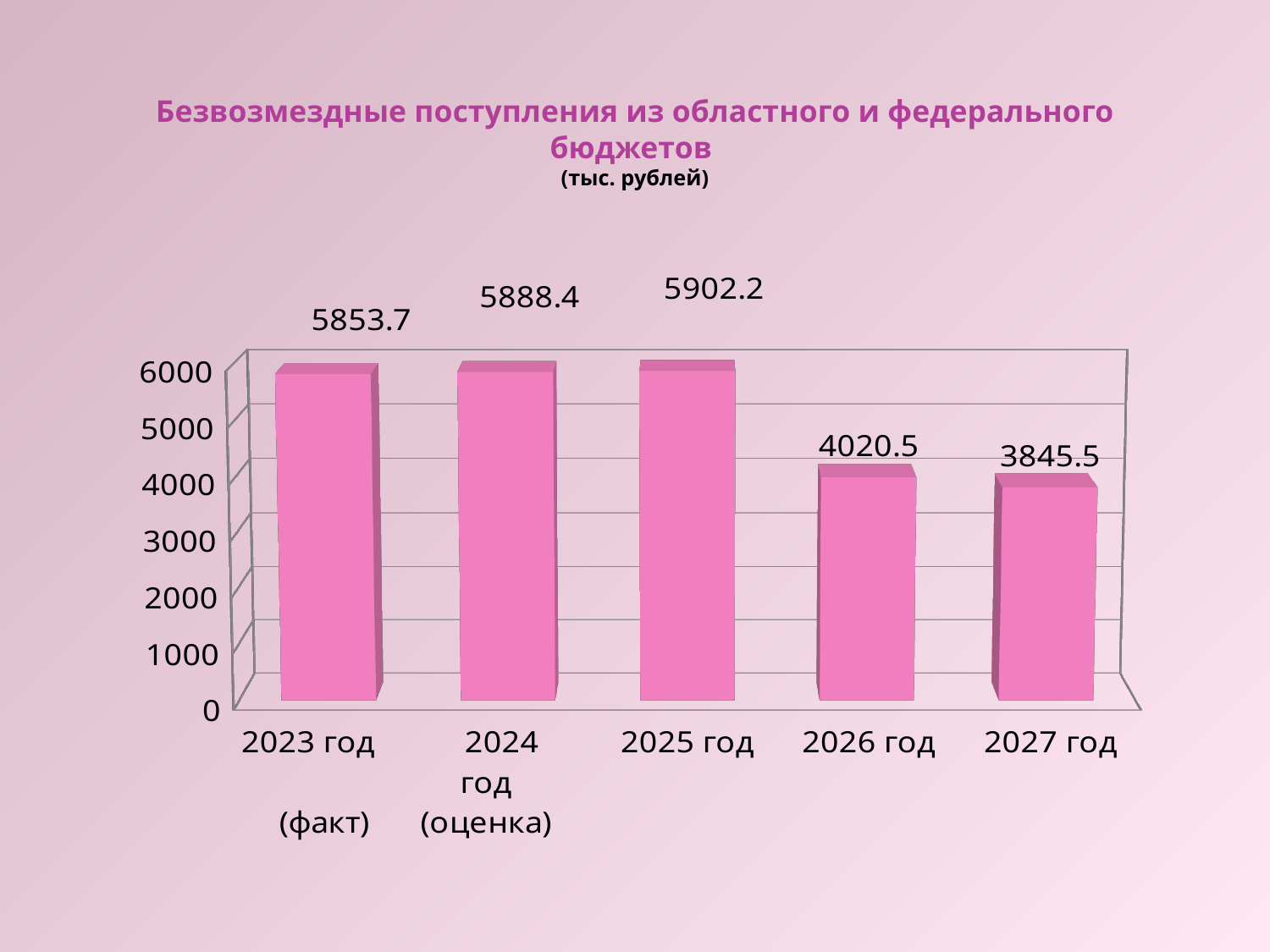
What is the value for 2023 год (факт)? 5853.7 What is the value for 2027 год? 3845.5 How many categories are shown on the x axis? 5 What kind of chart is shown on the slide? bar chart Which year has the lowest value? 2027 год What is the difference between the values for 2025 год and 2026 год? 1881.7 Which is larger, the value for 2023 год (факт) or the value for 2026 год? 2023 год (факт) What is the value for 2025 год? 5902.2 Which year has the highest value? 2025 год What is the difference between the values for 2026 год and 2027 год? 175 What is the value for 2024 год (оценка)? 5888.4 What unit is given under the chart title? тыс. рублей